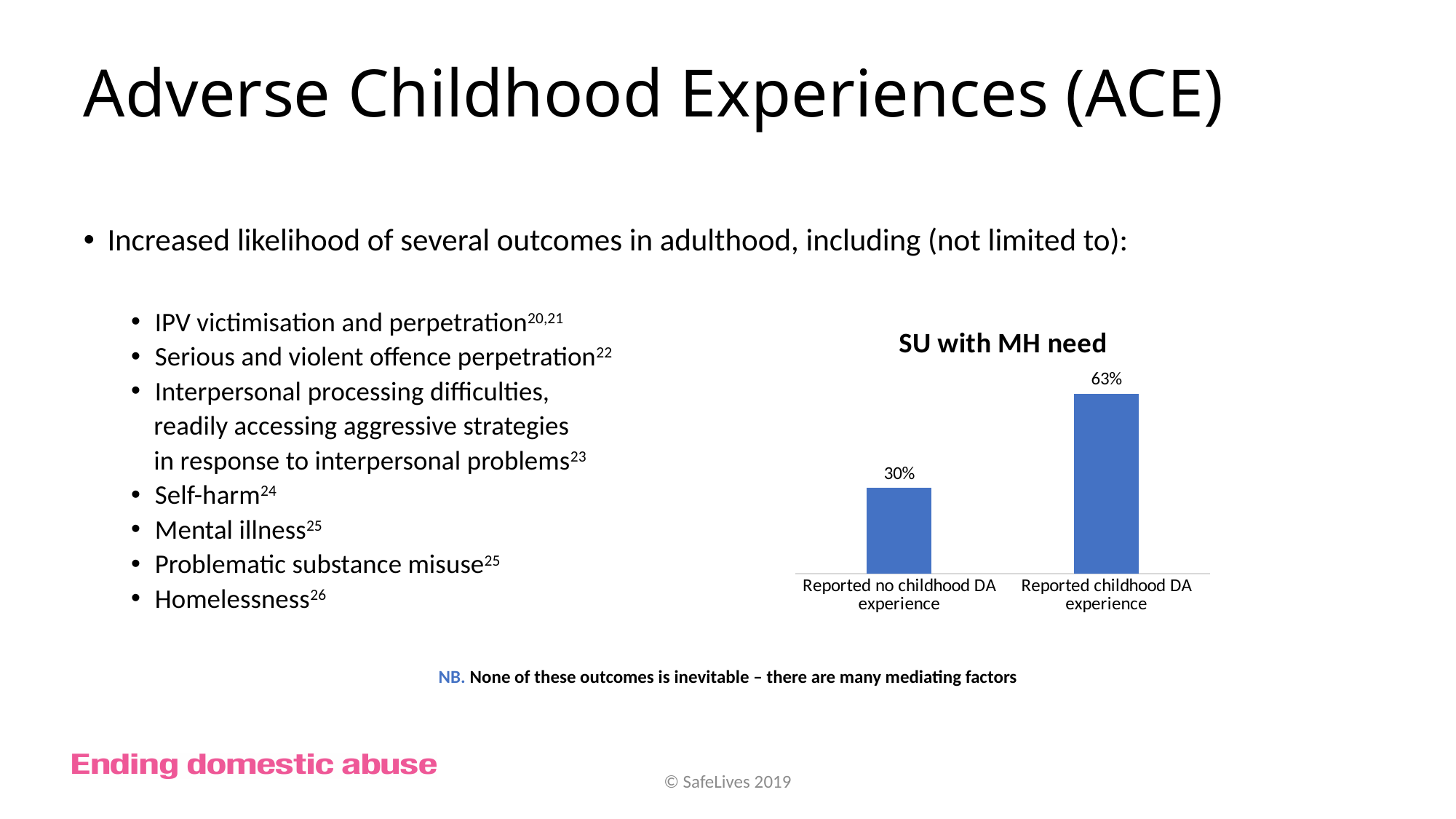
What colour are the bars in the chart? Blue What is the difference between the values for 'Reported childhood DA experience' and 'Reported no childhood DA experience'? 33% What is the value for 'Reported childhood DA experience' in the chart? 63% What kind of chart is shown on the slide? Bar chart Which category has the highest value in the chart? Reported childhood DA experience How many categories are shown in the chart? 2 Which is larger: the value for 'Reported childhood DA experience' or 'Reported no childhood DA experience'? Reported childhood DA experience What is the title of the chart? SU with MH need Which category has the lowest value in the chart? Reported no childhood DA experience What is the value for 'Reported no childhood DA experience' in the chart? 30%